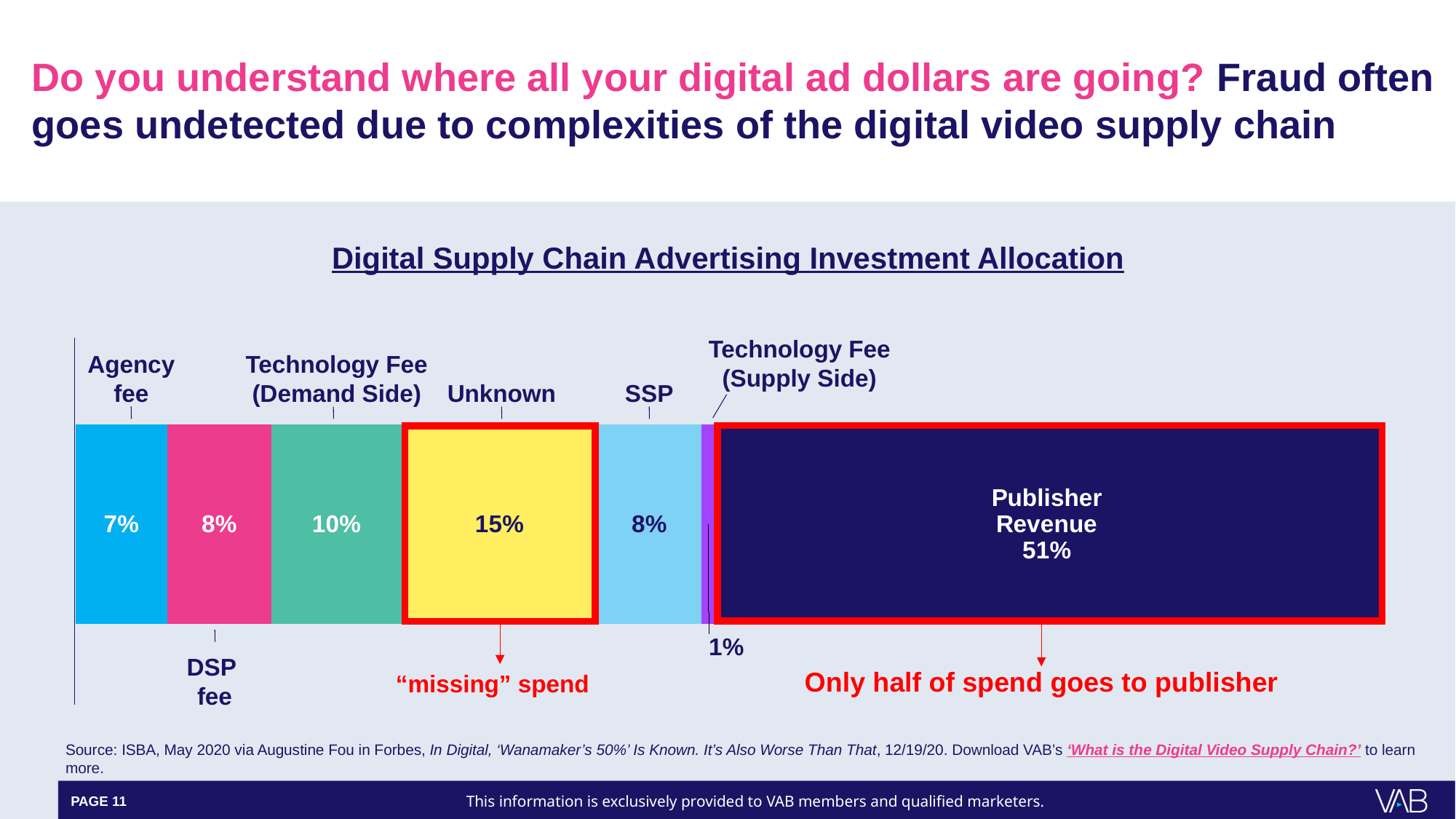
How many segments make up the stacked bar in the chart? 7 What is the combined share of the Agency fee and DSP fee segments? 15% What percentage of the digital supply chain advertising investment goes to Publisher Revenue? 51% Which is larger, the DSP fee share or the Agency fee share? DSP fee What share of spend is labelled Unknown in the Digital Supply Chain Advertising Investment Allocation chart? 15% Which segment of the chart has the smallest share? Technology Fee (Supply Side) What is the title of the chart on the slide? Digital Supply Chain Advertising Investment Allocation What is the difference between the Unknown share and the Technology Fee (Demand Side) share? 5% Which segment of the chart has the largest share? Publisher Revenue What kind of chart is shown on the slide? Bar chart What is the Technology Fee (Supply Side) share in the chart? 1% What is the Agency fee share in the chart? 7%